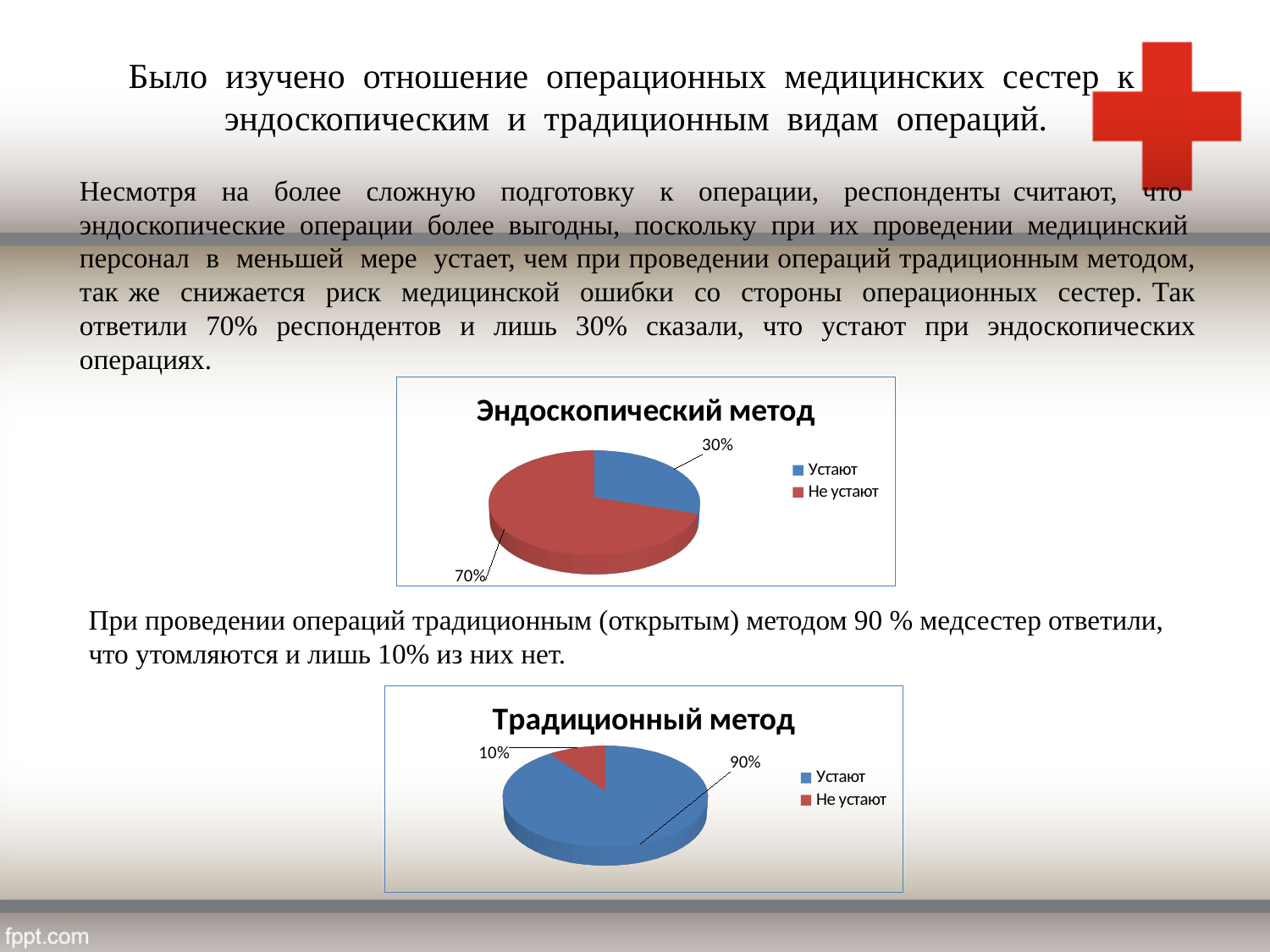
In the chart titled "Традиционный метод", which category has the smallest slice? Не устают In the chart titled "Эндоскопический метод", what share of the pie is "Устают"? 30% In the chart titled "Традиционный метод", what is the difference between the "Устают" and "Не устают" shares? 80% In the chart titled "Традиционный метод", what colour is the "Устают" slice? Blue In the chart titled "Эндоскопический метод", which category has the largest slice? Не устают What type of chart is the chart titled "Традиционный метод"? Pie chart In the chart titled "Эндоскопический метод", what is the difference between the "Не устают" and "Устают" shares? 40% In the chart titled "Традиционный метод", what share of the pie is "Не устают"? 10% How many categories does the legend of the chart titled "Эндоскопический метод" list? 2 In the chart titled "Традиционный метод", what share of the pie is "Устают"? 90% In the chart titled "Эндоскопический метод", which is larger: "Устают" or "Не устают"? Не устают In the chart titled "Эндоскопический метод", what share of the pie is "Не устают"? 70%